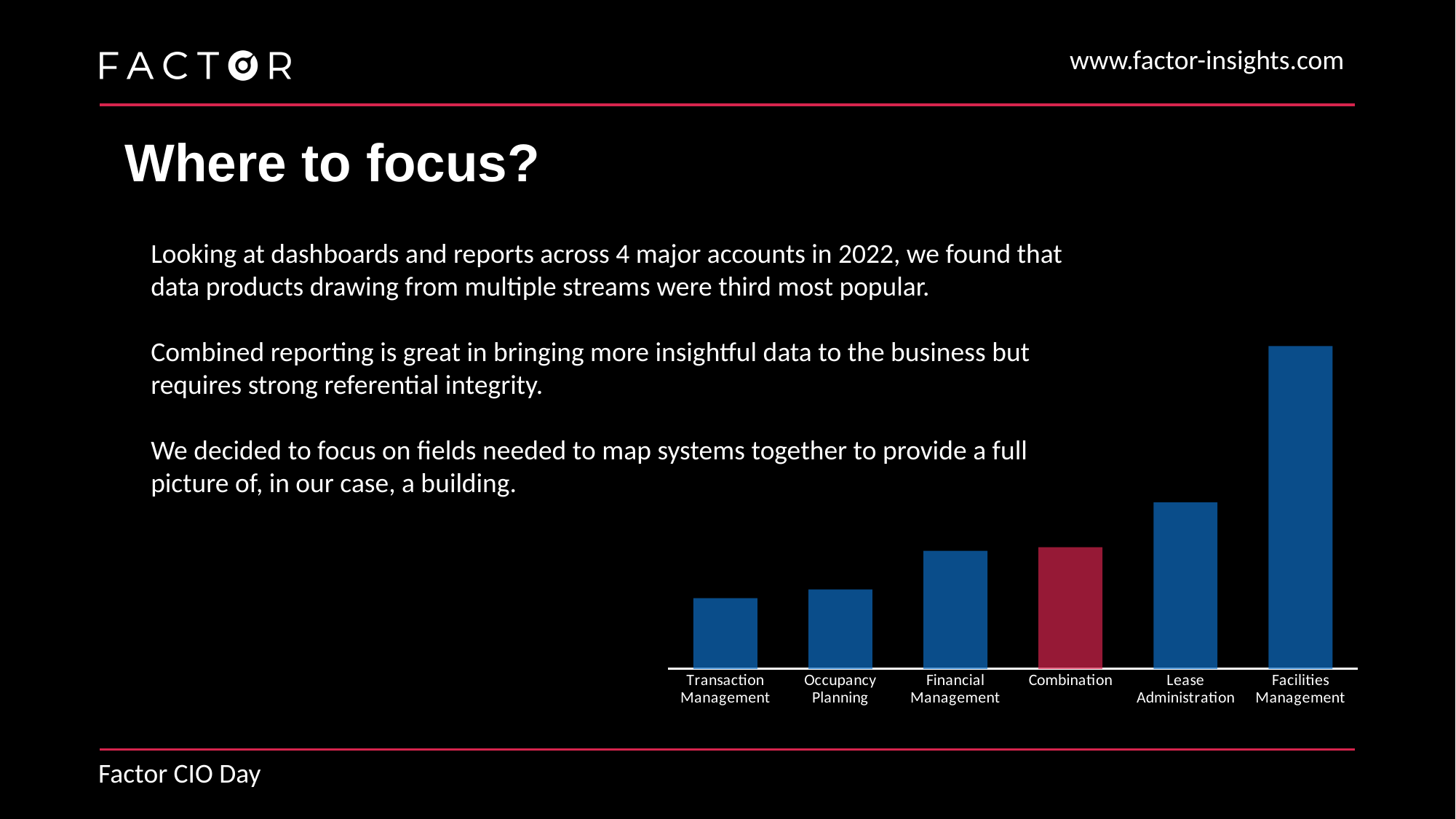
Which is larger, the bar for Facilities Management or the bar for Lease Administration? Facilities Management Which category has the highest bar? Facilities Management Which category's bar is coloured differently (red) from the others? Combination Which category is second highest on the bar chart? Lease Administration How many categories are shown on the bar chart? 6 Which is larger, the bar for Financial Management or the bar for Transaction Management? Financial Management What colour are the bars other than the Combination bar? Blue What kind of chart is shown on the slide? Bar chart Which is larger, the bar for Combination or the bar for Occupancy Planning? Combination Do the bar values rise or fall from left to right across the categories? Rise Which category has the lowest bar? Transaction Management